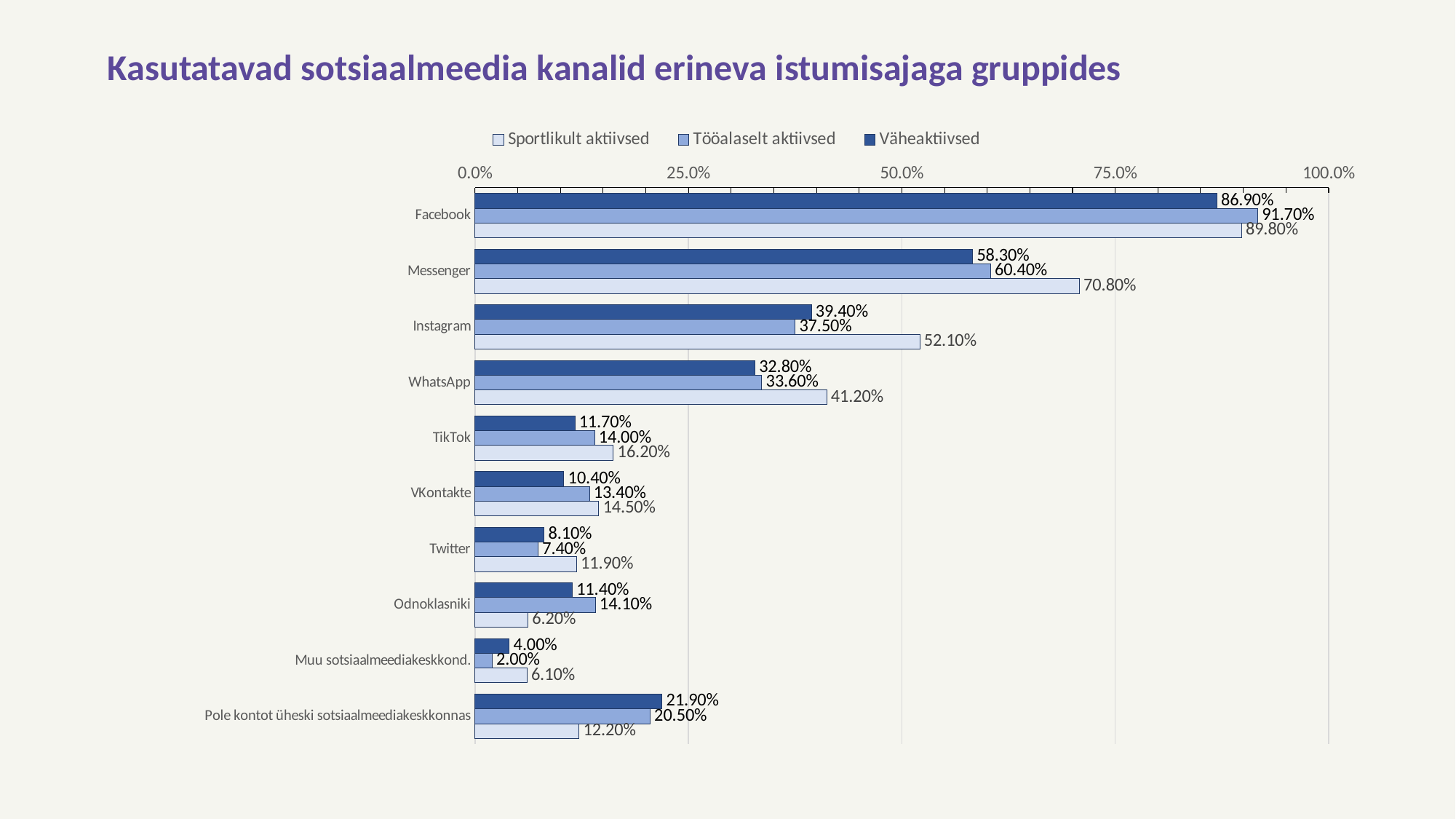
For Odnoklasniki, which series has the larger value: Sportlikult aktiivsed or Tööalaselt aktiivsed? Tööalaselt aktiivsed What is the value for Facebook in the Tööalaselt aktiivsed series? 91.70% What is the value for Instagram in the Väheaktiivsed series? 39.40% What kind of chart is shown on the slide? Bar chart Which category has the highest value in the Sportlikult aktiivsed series? Facebook What is the value for Messenger in the Sportlikult aktiivsed series? 70.80% What is the difference between the Sportlikult aktiivsed and Väheaktiivsed values for Messenger? 12.50% How many categories are shown on the chart? 10 How many series does the legend list? 3 What is the title of the chart? Kasutatavad sotsiaalmeedia kanalid erineva istumisajaga gruppides Which category has the lowest value in the Tööalaselt aktiivsed series? Muu sotsiaalmeediakeskkond. Is the Sportlikult aktiivsed value for Instagram greater or less than 50.0%? greater